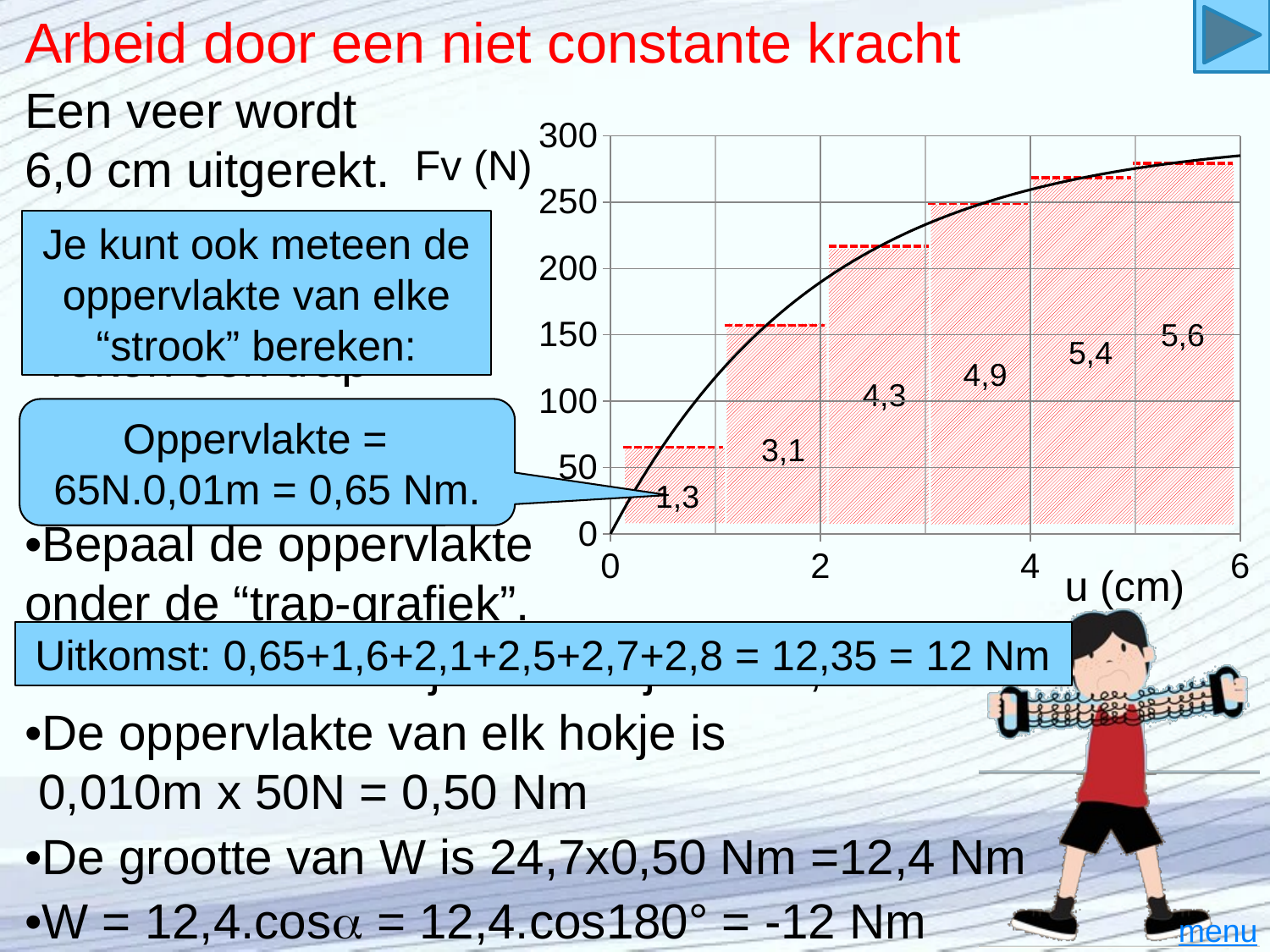
What is the label of the horizontal axis of the chart? u (cm) Is the value of Fv at u = 6 cm greater or less than 250? greater What kind of chart is shown on the slide? line chart Which shaded strip has the smallest printed number? the strip between 0 and 1 cm (1,3) What is the highest value shown on the vertical axis of the chart? 300 What number is printed in the shaded strip between u = 3 cm and u = 4 cm? 4,9 What number is printed in the shaded strip between u = 1 cm and u = 2 cm? 3,1 How many shaded strips are drawn under the curve in the chart? 6 Does the curve Fv rise or fall as u increases from 0 to 6 cm? rises What is the label of the vertical axis of the chart? Fv (N) Is the value of Fv at u = 4 cm greater or less than 200? greater Which shaded strip has the largest printed number? the strip between 5 and 6 cm (5,6)